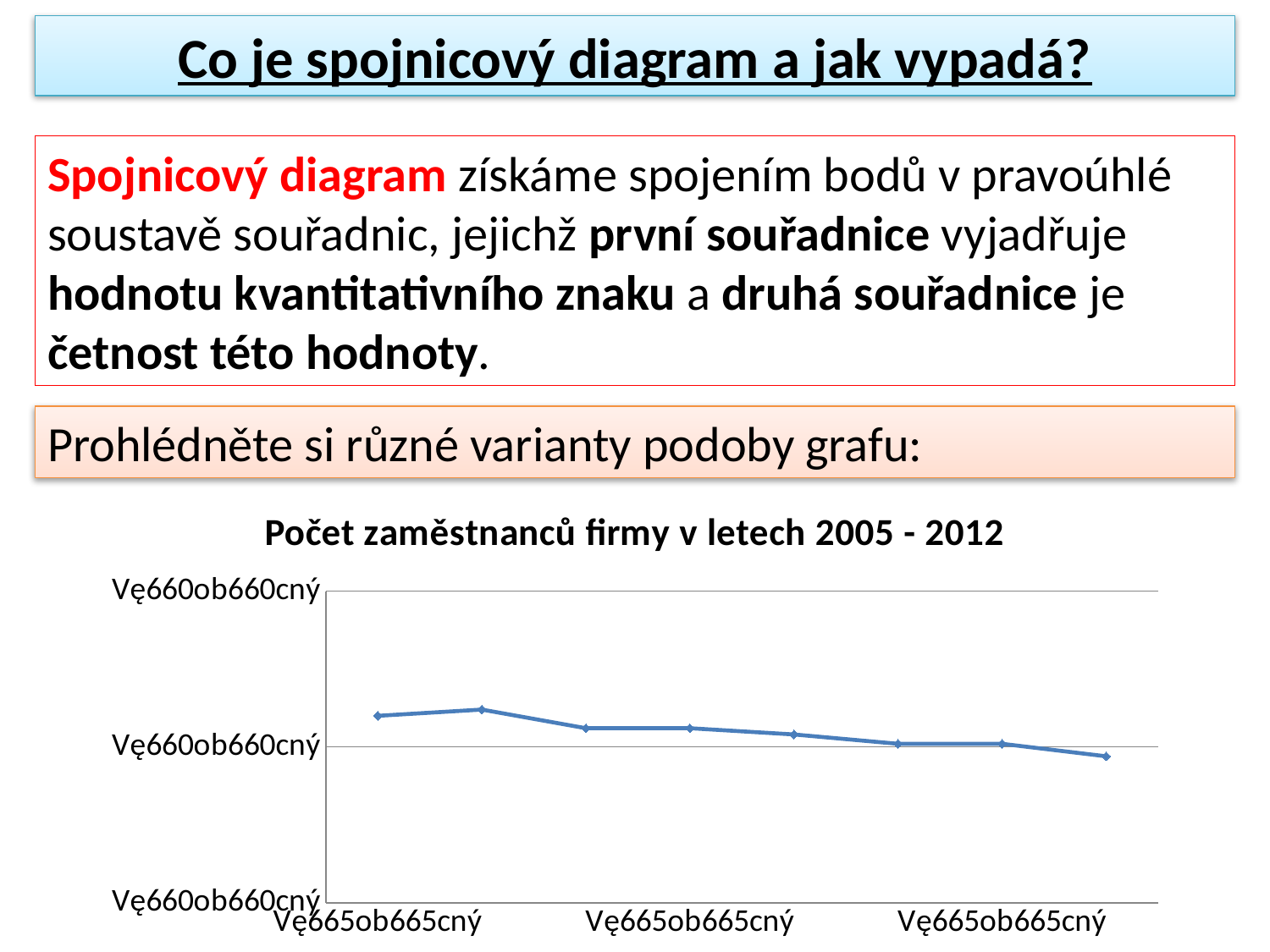
Do the values generally rise or fall from left to right along the x axis? fall Is the last point on the line higher or lower than the first point? lower Which point on the line is the lowest: the first, the second, or the last? the last How many data points are plotted on the line? 8 What colour is the plotted line? blue How many lines (series) are plotted in the chart? 1 Is the second point on the line higher or lower than the third point? higher What kind of chart is shown on the slide? line chart What is the title of the chart? Počet zaměstnanců firmy v letech 2005 - 2012 Which point on the line is the highest: the first, the second, or the last? the second